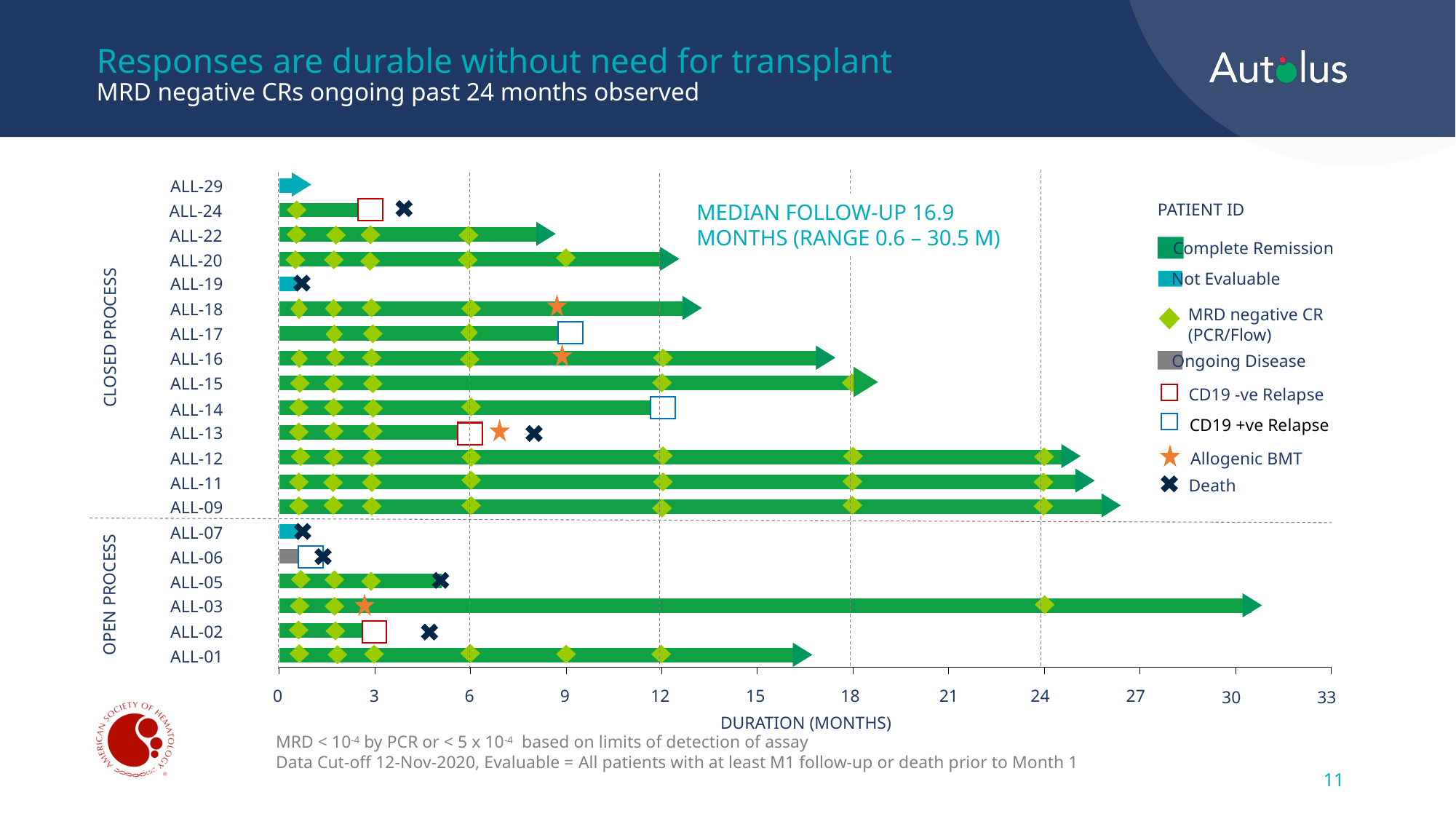
Is the duration for ALL-24 greater or less than 6 months? less What is the median follow-up stated on the chart? 16.9 months How many entries does the legend list? 8 How many patients are listed under CLOSED PROCESS? 14 How many patient IDs are plotted on the chart? 20 Is the duration for ALL-09 greater or less than 24 months? greater Is the duration for ALL-03 greater or less than 27 months? greater Which patient has the longest bar on the chart? ALL-03 What kind of chart is shown on the slide? bar chart What is the title of the x axis? DURATION (MONTHS) Which patient has the longer bar, ALL-20 or ALL-22? ALL-20